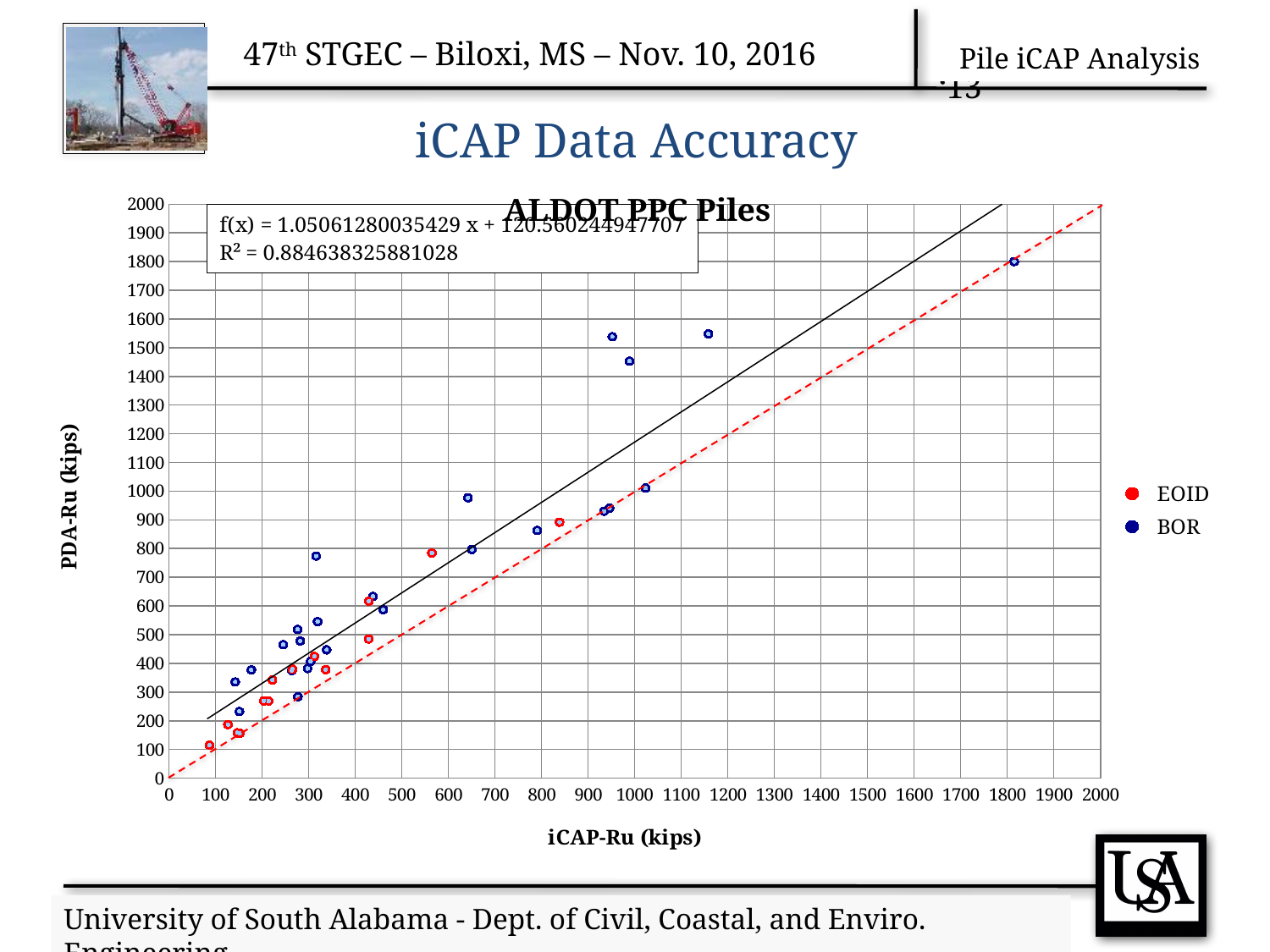
What kind of chart is shown on the slide? scatter chart Which series has more points plotted above 1400 on the PDA-Ru axis, EOID or BOR? BOR Do the plotted PDA-Ru values generally rise or fall as iCAP-Ru increases along the x axis? rise What is the title of the chart? ALDOT PPC Piles How many series does the chart legend list? 2 Is the highest plotted PDA-Ru value greater or less than 1700? greater What are the two series named in the chart legend? EOID and BOR Which series contains the point with the highest PDA-Ru value? BOR What is the maximum value shown on the x axis (iCAP-Ru)? 2000 What is the slope of the trendline equation printed on the chart? 1.05061280035429 Is the lowest plotted PDA-Ru value for the EOID series greater or less than 200? less What R² value is printed on the chart for the trendline? 0.884638325881028